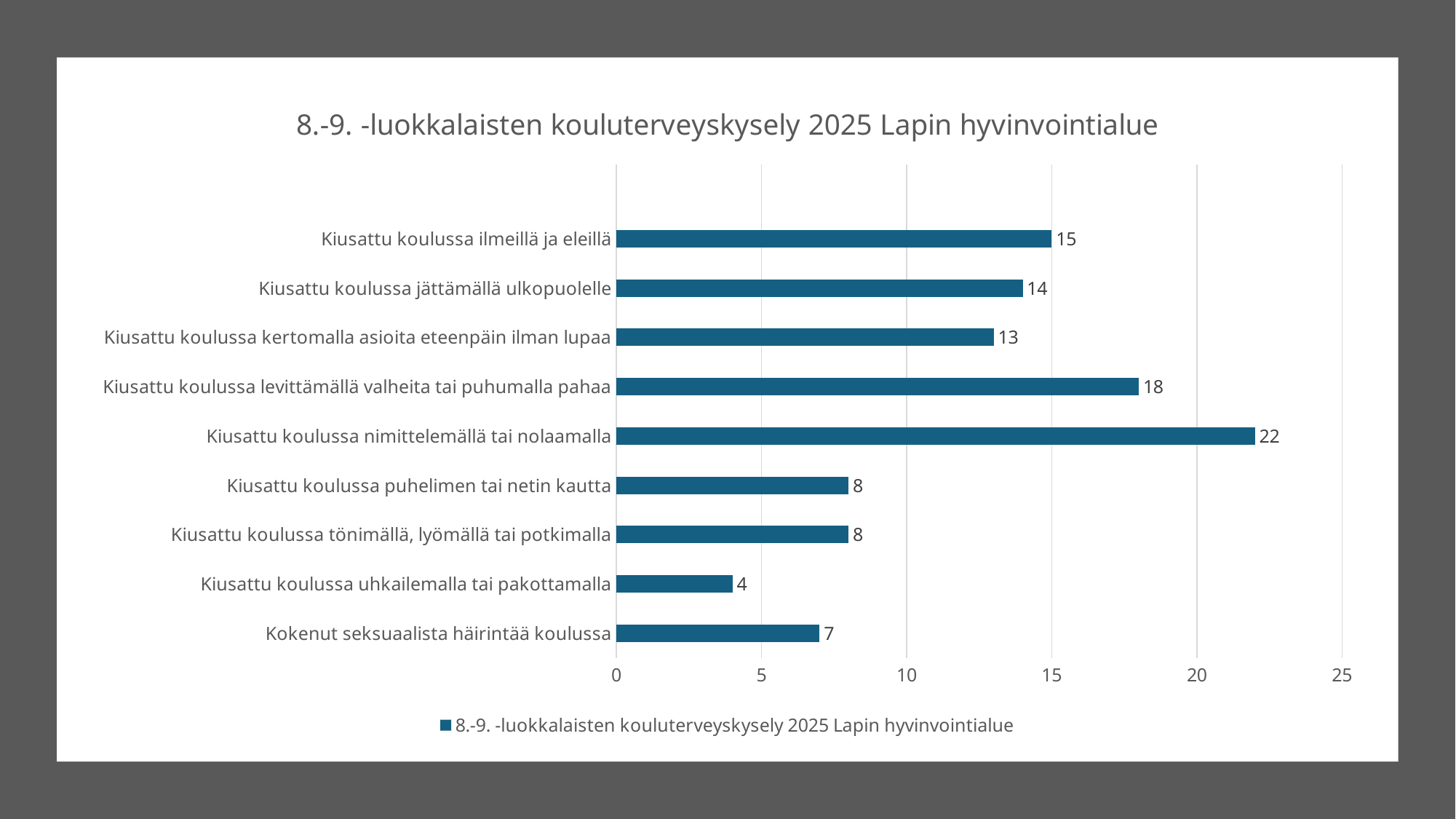
What is the value for "Kiusattu koulussa levittämällä valheita tai puhumalla pahaa"? 18 What is the value for "Kokenut seksuaalista häirintää koulussa"? 7 How many categories are shown in the chart? 9 Which category has the highest value? Kiusattu koulussa nimittelemällä tai nolaamalla Which is larger: the value for "Kiusattu koulussa ilmeillä ja eleillä" or "Kiusattu koulussa jättämällä ulkopuolelle"? Kiusattu koulussa ilmeillä ja eleillä What is the value for "Kiusattu koulussa nimittelemällä tai nolaamalla"? 22 Which category has the lowest value? Kiusattu koulussa uhkailemalla tai pakottamalla What is the difference between the values for "Kiusattu koulussa nimittelemällä tai nolaamalla" and "Kiusattu koulussa uhkailemalla tai pakottamalla"? 18 How many series does the legend list? 1 What is the title of the chart? 8.-9. -luokkalaisten kouluterveyskysely 2025 Lapin hyvinvointialue What kind of chart is shown on the slide? bar chart Is the value for "Kiusattu koulussa kertomalla asioita eteenpäin ilman lupaa" greater or less than 10? greater